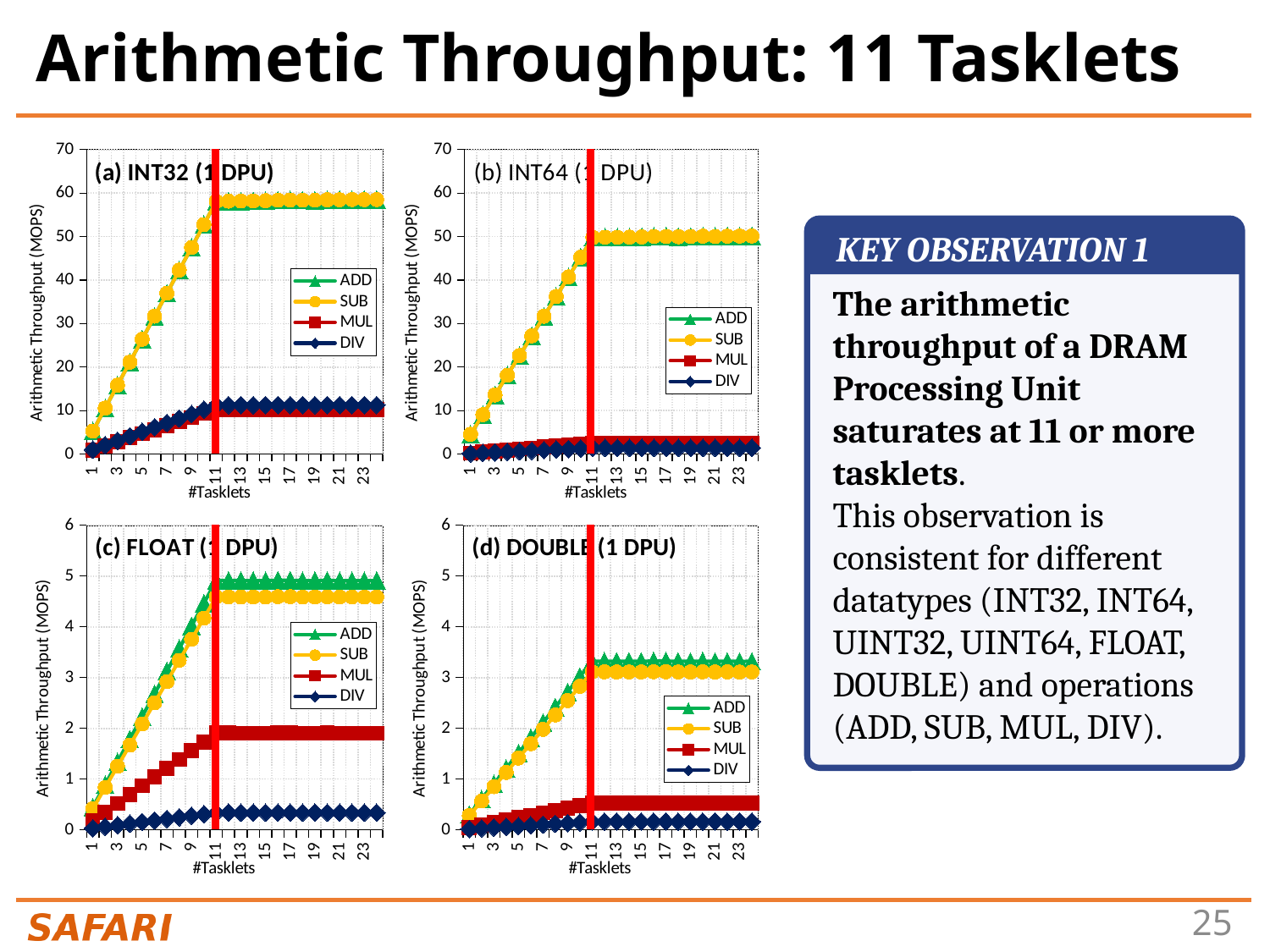
In chart (c) FLOAT (1 DPU), which series has the lowest throughput at 23 tasklets? DIV In chart (c) FLOAT (1 DPU), which is larger at 23 tasklets, ADD or DIV? ADD In chart (c) FLOAT (1 DPU), is the MUL value at 23 tasklets greater or less than 1? greater What is the y-axis label of chart (b) INT64 (1 DPU)? Arithmetic Throughput (MOPS) What are the legend entries in chart (c) FLOAT (1 DPU)? ADD, SUB, MUL, DIV In chart (d) DOUBLE (1 DPU), is the DIV value at 23 tasklets greater or less than 1? less In chart (a) INT32 (1 DPU), is the ADD value at 23 tasklets greater or less than 50? greater In chart (a) INT32 (1 DPU), does the ADD series rise or fall as the number of tasklets increases from 1 to 11? rise How many series does the legend of chart (a) INT32 (1 DPU) list? 4 What kind of chart is chart (a) INT32 (1 DPU)? line chart